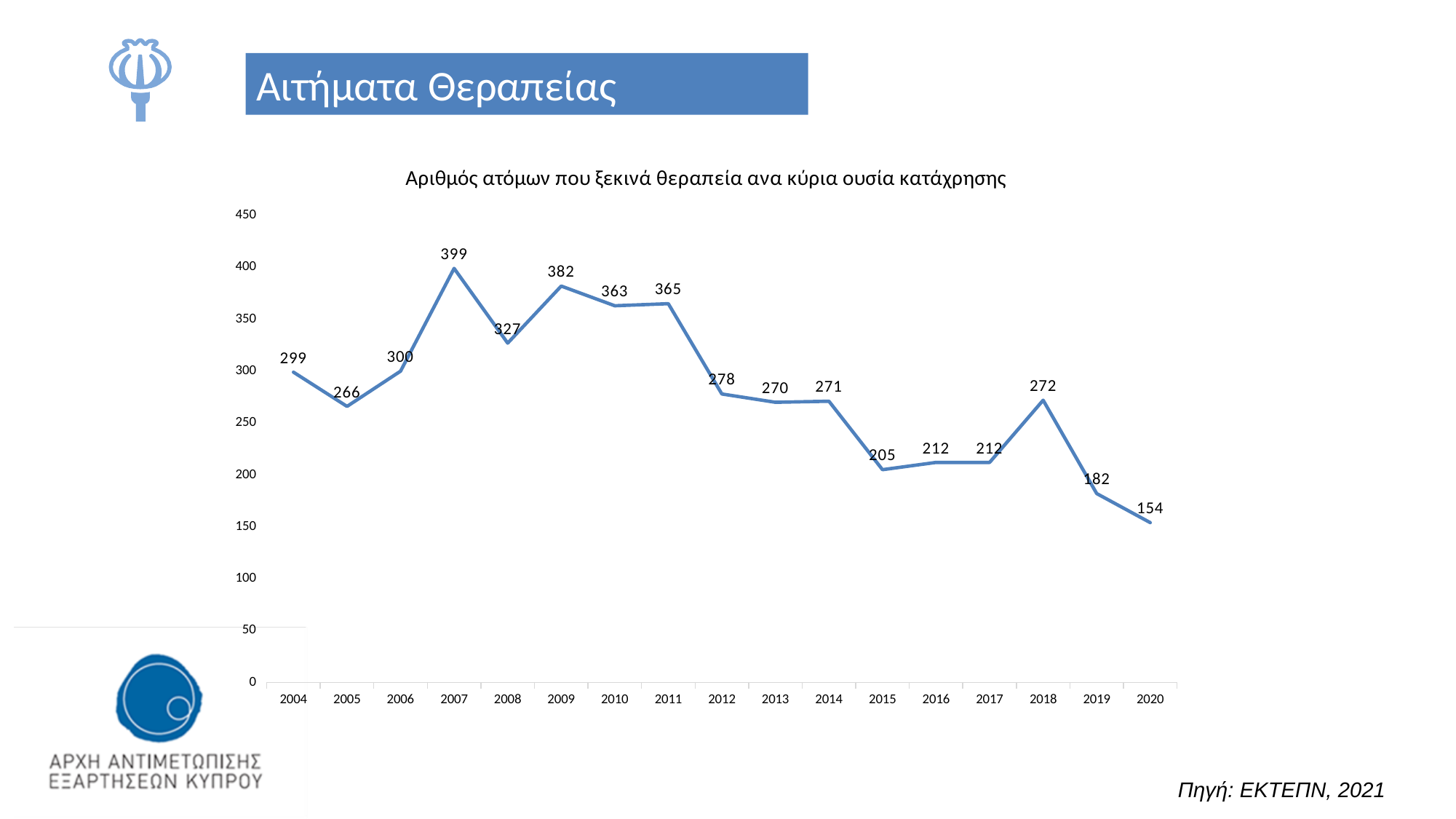
What is the value for 2020? 154 How many years are plotted on the x axis? 17 What is the difference between the values for 2018 and 2019? 90 Which year has the highest value? 2007 Which year has the lowest value? 2020 What kind of chart is shown? line chart Is the value for 2015 greater or less than 250? less What is the value for 2012? 278 What is the difference between the values for 2007 and 2008? 72 What is the value for 2007? 399 Do the values rise or fall from 2011 to 2015? fall Which is larger, the value for 2009 or the value for 2011? 2009